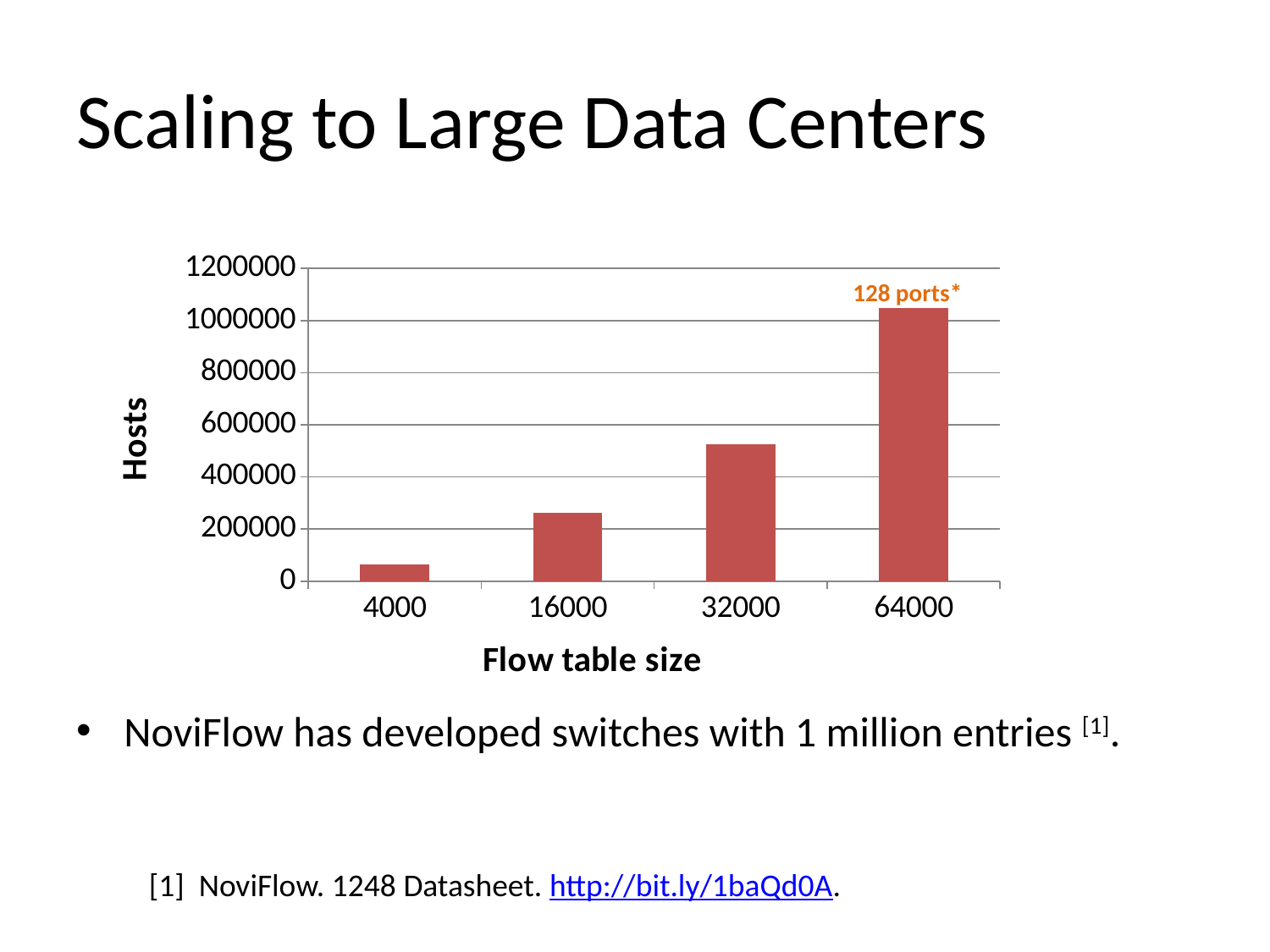
What is the label of the y axis of the chart? Hosts What kind of chart is shown on the slide? bar chart Is the number of hosts for a flow table size of 16000 greater or less than 200000? greater Is the number of hosts for a flow table size of 64000 greater or less than 1000000? greater Which flow table size has the lowest number of hosts? 4000 Which flow table size has the highest number of hosts? 64000 Is the number of hosts for a flow table size of 32000 greater or less than 600000? less Which has more hosts, a flow table size of 16000 or 32000? 32000 What annotation is printed above the bar for a flow table size of 64000? 128 ports* Do the number of hosts rise or fall as the flow table size increases along the x axis? rise How many flow table size categories are plotted on the x axis? 4